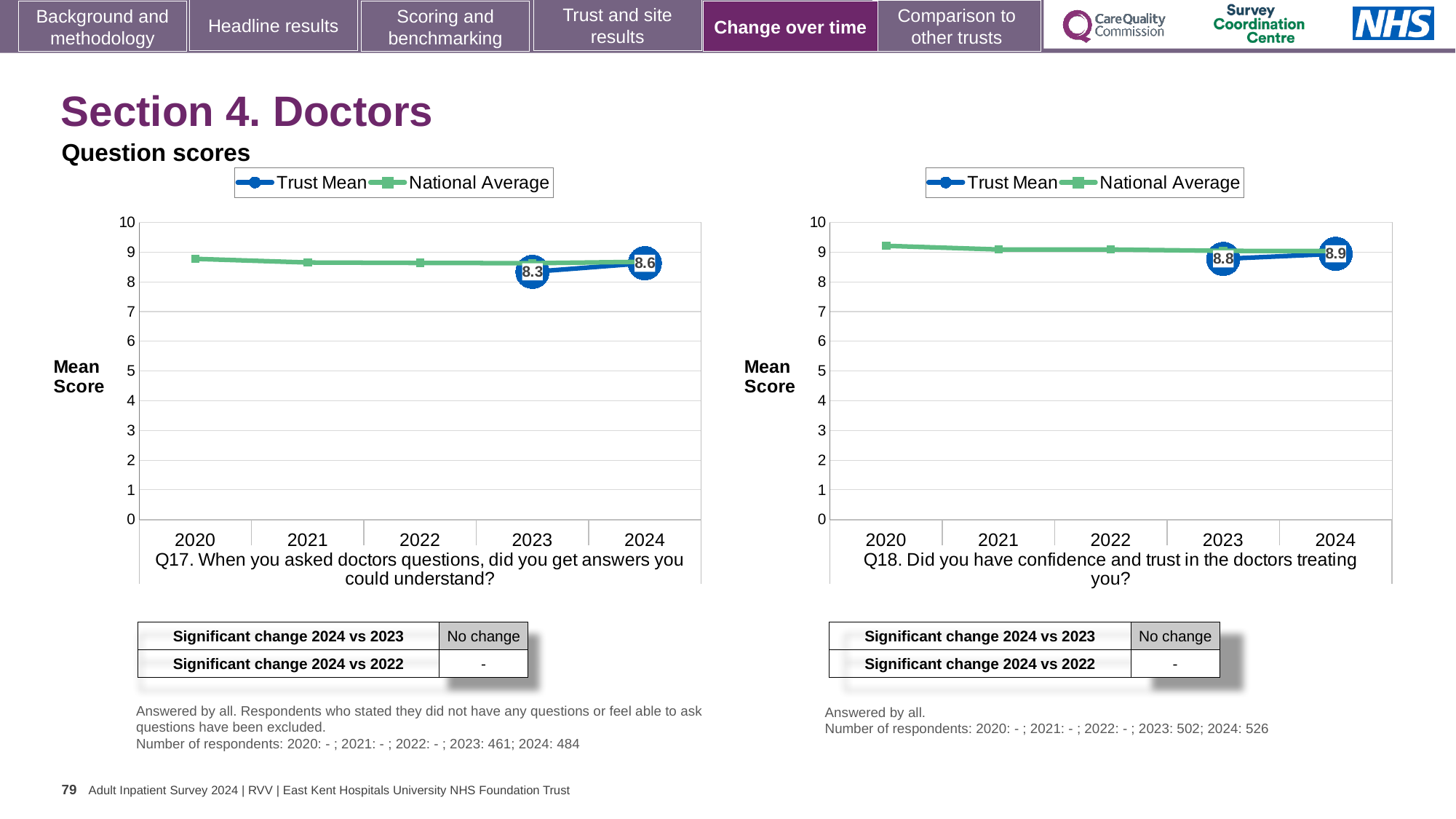
In the Q17 chart (left), is the National Average for 2020 greater or less than 8? greater In the Q17 chart (left), by how much did the Trust Mean change from 2023 to 2024? 0.3 In the Q18 chart (right), what is the Trust Mean score for 2023? 8.8 How many years are shown on the x axis of the Q17 chart (left)? 5 In the Q17 chart (left), does the Trust Mean rise or fall from 2023 to 2024? rise Which series is shown in blue in the Q17 chart (left)? Trust Mean In the Q18 chart (right), is the National Average for 2020 greater or less than 9? greater In the Q17 chart (left), what is the Trust Mean score for 2023? 8.3 In the Q18 chart (right), what is the Trust Mean score for 2024? 8.9 In the Q17 chart (left), what is the Trust Mean score for 2024? 8.6 How many series does the legend of the Q18 chart (right) list? 2 What kind of chart is the Q18 chart (right)? line chart